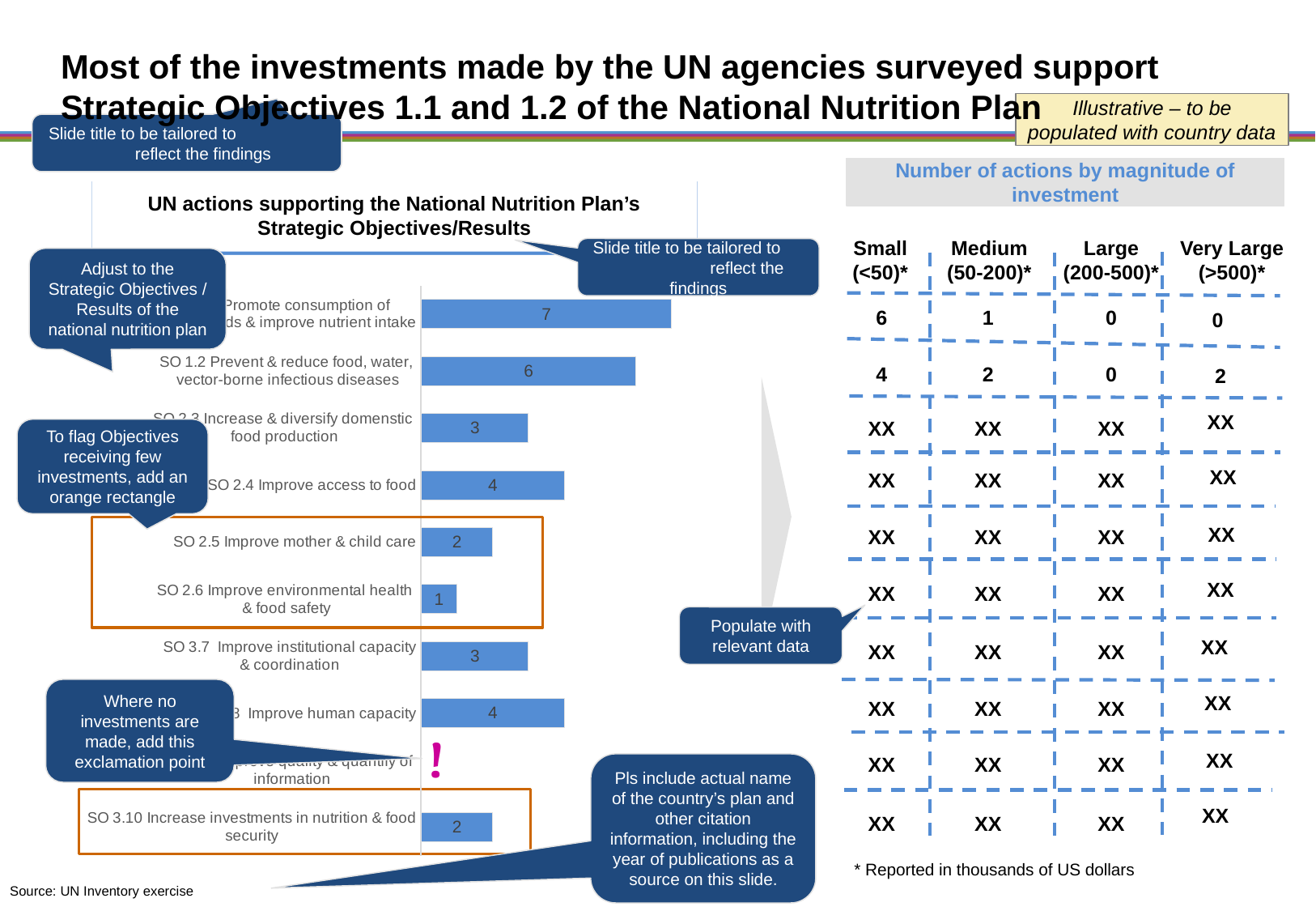
In the bar chart, what is the difference between the value for SO 1.2 and the value for SO 2.6? 5 What source is cited at the bottom left of the slide for the chart? UN Inventory exercise What type of chart is shown on the left of the slide? Bar chart In the bar chart, what is the value for SO 3.10 Increase investments in nutrition & food security? 2 What is the largest value shown on any bar in the chart? 7 In the bar chart, what is the value for SO 3.7 Improve institutional capacity & coordination? 3 In the bar chart, which has the larger value: SO 2.4 Improve access to food or SO 2.5 Improve mother & child care? SO 2.4 Improve access to food In the bar chart, what is the value for SO 2.4 Improve access to food? 4 In the bar chart, what is the value for SO 2.6 Improve environmental health & food safety? 1 In the bar chart, what is the value for SO 2.5 Improve mother & child care? 2 Among the categories with a bar, which has the lowest value in the chart? SO 2.6 Improve environmental health & food safety In the chart 'UN actions supporting the National Nutrition Plan's Strategic Objectives/Results', how many UN actions support SO 1.2 Prevent & reduce food, water, vector-borne infectious diseases? 6